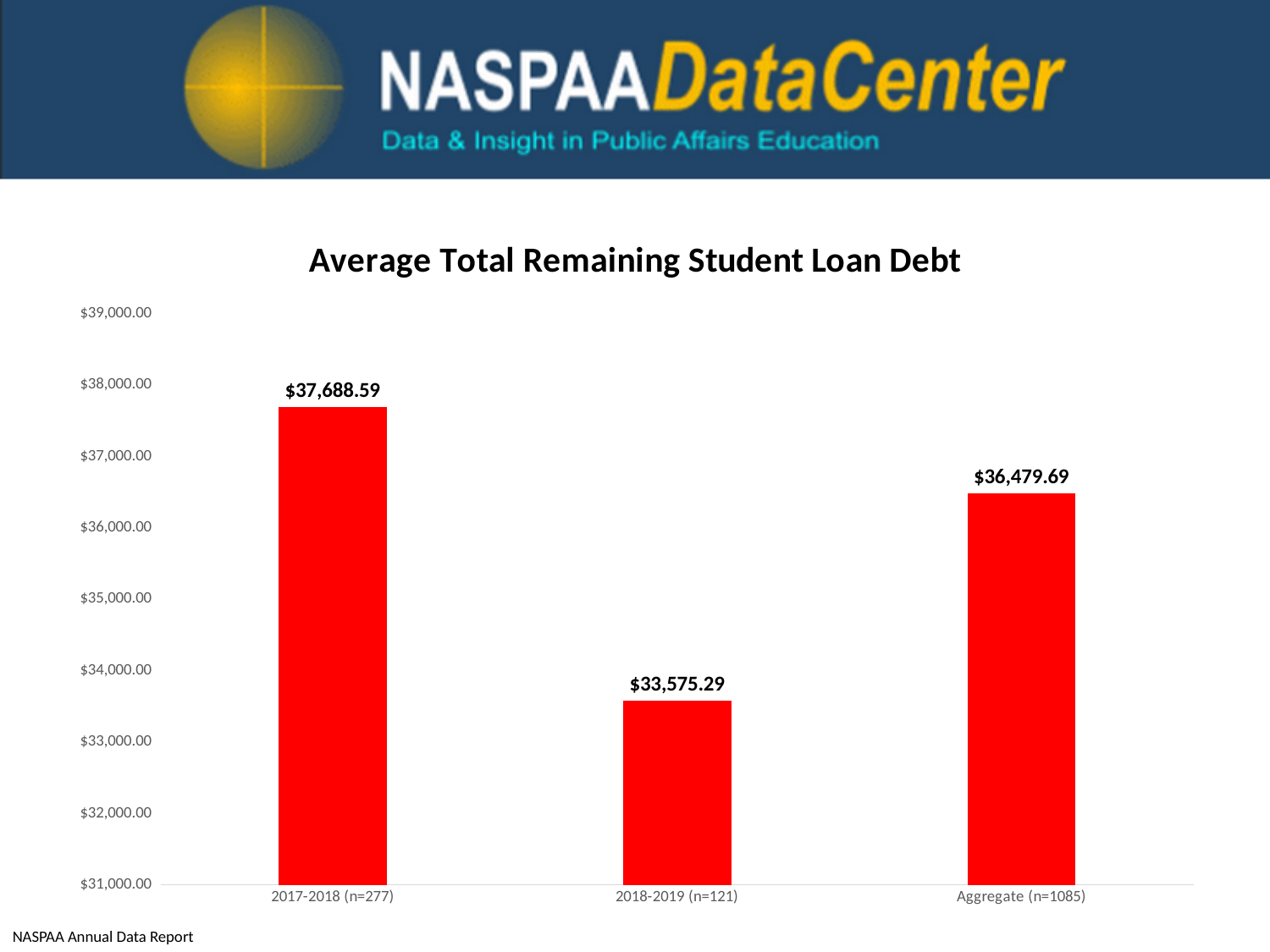
Which category has the lowest average total remaining student loan debt? 2018-2019 (n=121) Which is larger, the value for 2017-2018 or the value for Aggregate? 2017-2018 How many categories are shown on the chart? 3 What is the average total remaining student loan debt for Aggregate (n=1085)? $36,479.69 What is the difference between the Aggregate value and the 2018-2019 value? $2,904.40 What is the average total remaining student loan debt for 2018-2019 (n=121)? $33,575.29 What kind of chart is shown on the slide? Bar chart What is the difference between the 2017-2018 value and the 2018-2019 value? $4,113.30 What is the average total remaining student loan debt for 2017-2018 (n=277)? $37,688.59 What is the title of the chart? Average Total Remaining Student Loan Debt Which category has the highest average total remaining student loan debt? 2017-2018 (n=277) Is the value for 2018-2019 greater or less than $34,000.00? less